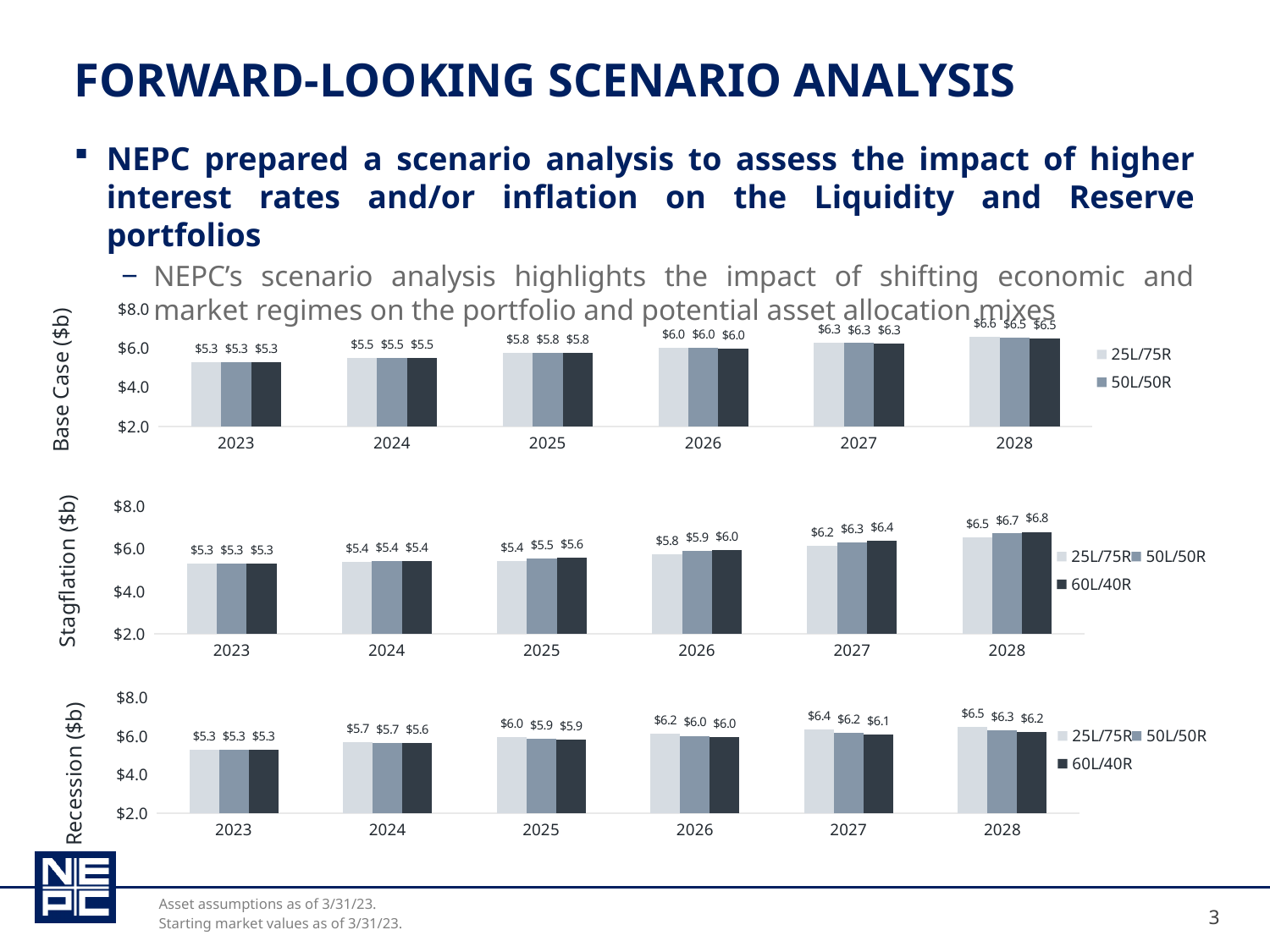
In the Base Case chart, what is the value for 25L/75R in 2028? $6.6 What is the y-axis label of the middle chart? Stagflation ($b) In the Stagflation chart, what is the difference between the 60L/40R and 25L/75R values in 2028? $0.3 In the Stagflation chart, which year has the highest value for 60L/40R? 2028 How many series does the legend of the Stagflation chart list? 3 In the Stagflation chart, what is the value for 60L/40R in 2028? $6.8 How many years are shown on the x axis of the Recession chart? 6 In the Recession chart, which is larger in 2027: 25L/75R or 60L/40R? 25L/75R In the Recession chart, what is the value for 25L/75R in 2027? $6.4 What kind of chart is the Base Case chart? Bar chart In the Base Case chart, do the 25L/75R values rise or fall from 2023 to 2028? Rise In the Recession chart, which year has the lowest value for 25L/75R? 2023